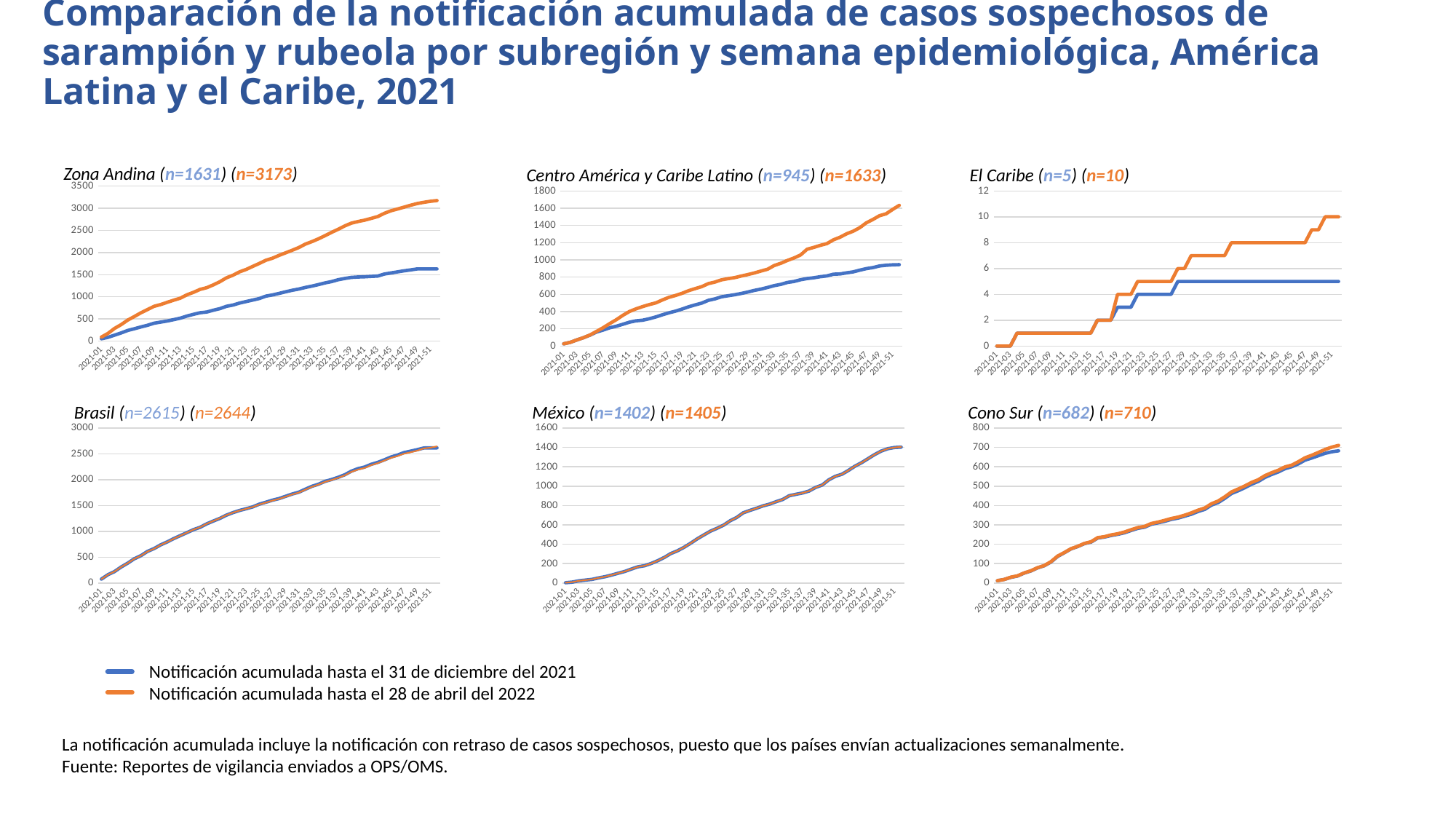
Across the six charts, which subregion has the highest n value for the notification accumulated until 28 April 2022? Zona Andina In the El Caribe chart, what is the n value for the notification accumulated until 31 December 2021? n=5 How many series does the legend at the bottom of the slide list? 2 In the Centro América y Caribe Latino chart, what is the difference between the n value for 28 April 2022 and the n value for 31 December 2021? 688 What kind of chart is used for each subregion on this slide? line chart Across the six charts, which subregion has the lowest n value for the notification accumulated until 28 April 2022? El Caribe In the Cono Sur chart, what is the difference between the n value for 28 April 2022 (710) and the n value for 31 December 2021 (682)? 28 In the México chart, do the lines rise or fall along the x axis from 2021-01 to 2021-51? rise In the Brasil chart, which series has the larger n value: notification until 31 December 2021 or until 28 April 2022? until 28 April 2022 How many subregion charts are shown on the slide? 6 In the Zona Andina chart, what is the n value for the notification accumulated until 28 April 2022? n=3173 In the Zona Andina chart, is the value of the blue line at week 2021-51 greater or less than 1500? greater